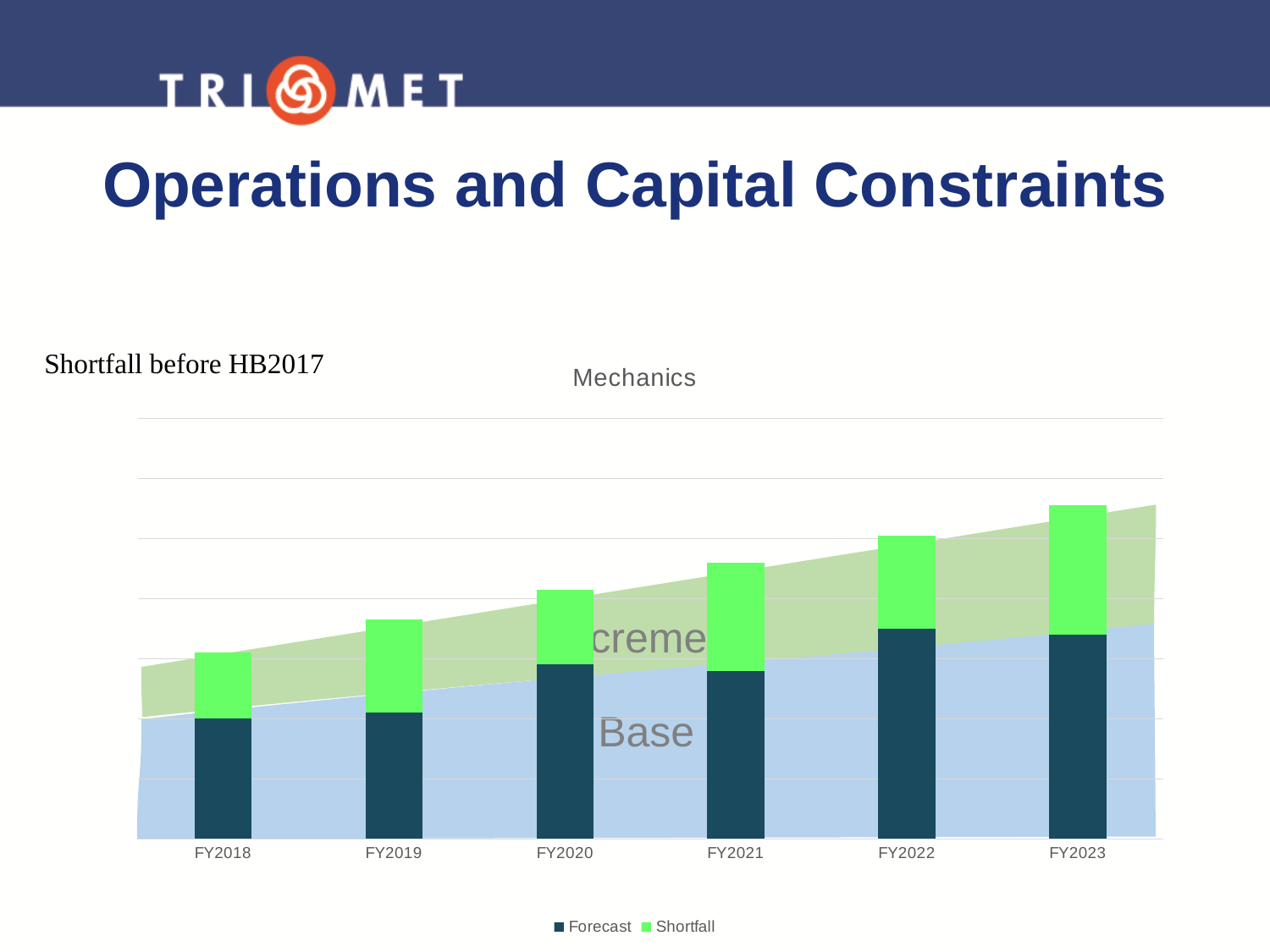
How many series does the legend list? 2 Which fiscal year has the largest Shortfall segment? FY2023 Which fiscal year is the first category on the x axis? FY2018 Which is larger, the total stacked bar for FY2023 or for FY2018? FY2023 What is the title of the chart? Mechanics Which fiscal year has the tallest stacked bar overall? FY2023 What kind of chart is shown on the slide? Stacked bar chart Which is larger, the Forecast segment for FY2021 or for FY2018? FY2021 How many fiscal years are shown on the x axis? 6 Do the total bar heights rise or fall from FY2018 to FY2023? Rise Which fiscal year has the shortest stacked bar overall? FY2018 What are the two series named in the legend? Forecast and Shortfall